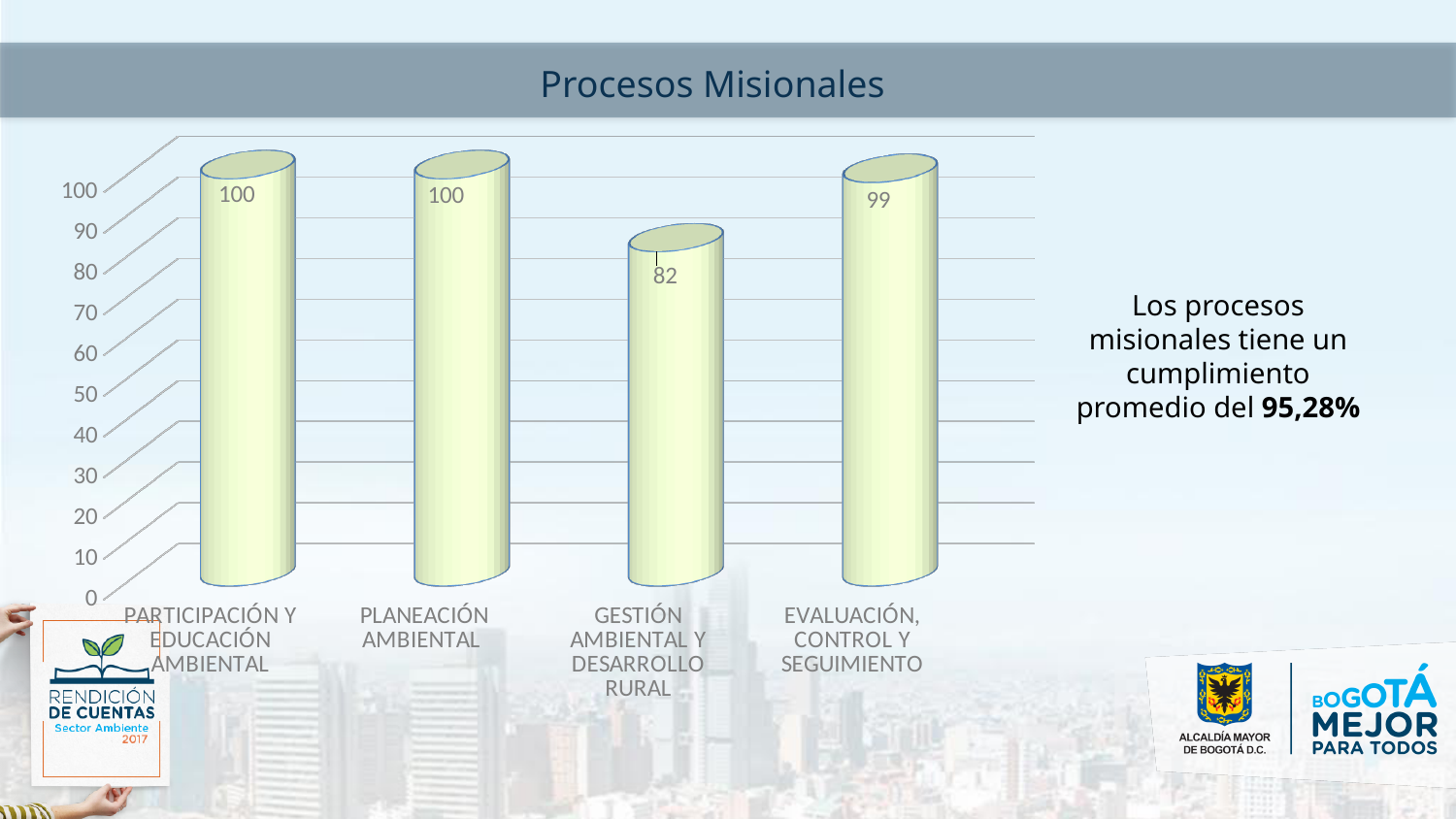
What is the value for PARTICIPACIÓN Y EDUCACIÓN AMBIENTAL? 100 How many categories are shown in the chart? 4 What is the value for GESTIÓN AMBIENTAL Y DESARROLLO RURAL? 82 What kind of chart is shown on the slide? bar chart Which category has the lowest value? GESTIÓN AMBIENTAL Y DESARROLLO RURAL What is the difference between the values for EVALUACIÓN, CONTROL Y SEGUIMIENTO and GESTIÓN AMBIENTAL Y DESARROLLO RURAL? 17 What is the value for PLANEACIÓN AMBIENTAL? 100 Is the value for GESTIÓN AMBIENTAL Y DESARROLLO RURAL greater or less than 90? less What is the value for EVALUACIÓN, CONTROL Y SEGUIMIENTO? 99 What is the difference between the values for PLANEACIÓN AMBIENTAL and GESTIÓN AMBIENTAL Y DESARROLLO RURAL? 18 Which is larger, the value for EVALUACIÓN, CONTROL Y SEGUIMIENTO or the value for GESTIÓN AMBIENTAL Y DESARROLLO RURAL? EVALUACIÓN, CONTROL Y SEGUIMIENTO What is the title of the slide containing the chart? Procesos Misionales